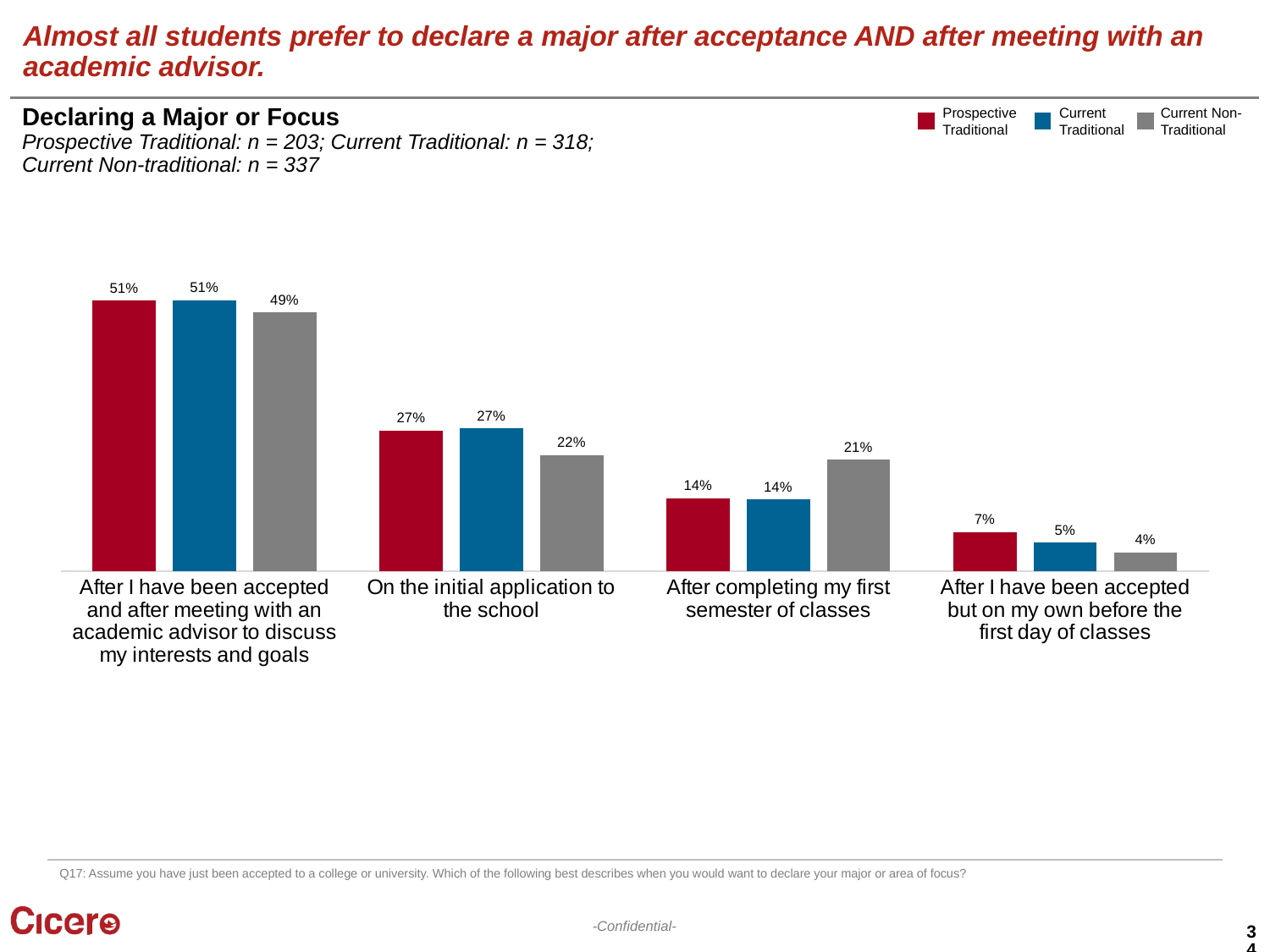
What is the difference between the Prospective Traditional and Current Non-Traditional values for 'After completing my first semester of classes'? 7 percentage points What is the value for Prospective Traditional students for 'After I have been accepted and after meeting with an academic advisor to discuss my interests and goals'? 51% How many categories are shown on the x axis? 4 How many series does the legend list? 3 Which category has the highest value for Current Traditional students? After I have been accepted and after meeting with an academic advisor to discuss my interests and goals What is the title of the chart? Declaring a Major or Focus For 'On the initial application to the school', which is larger: the Current Traditional value or the Current Non-Traditional value? Current Traditional What is the value for Current Non-Traditional students for 'After completing my first semester of classes'? 21% What kind of chart is shown on the slide? Bar chart What is the value for Current Non-Traditional students for 'On the initial application to the school'? 22% Which category has the lowest value for Current Non-Traditional students? After I have been accepted but on my own before the first day of classes What is the value for Current Traditional students for 'After I have been accepted but on my own before the first day of classes'? 5%